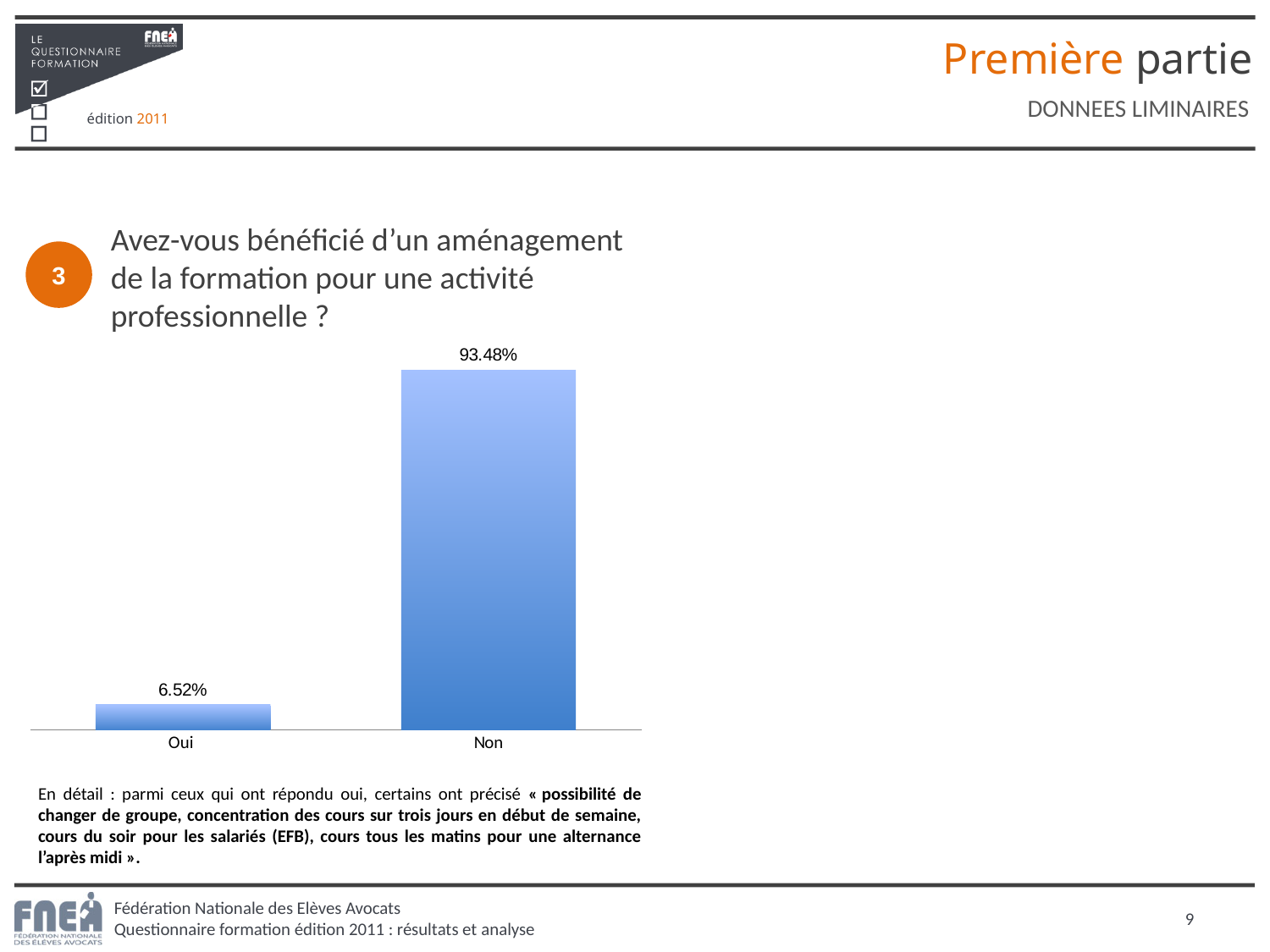
What is the difference between the values for Non and Oui? 86.96% Which category has the highest value? Non How many categories are shown in the chart? 2 What are the category labels on the x axis of the chart? Oui, Non Which is larger, the value for Oui or the value for Non? Non What is the total of the two values shown in the chart? 100% What kind of chart is shown on the slide? bar chart What is the value for Non? 93.48% What question does the chart answer? Avez-vous bénéficié d'un aménagement de la formation pour une activité professionnelle ? Which category has the lowest value? Oui What is the value for Oui? 6.52%